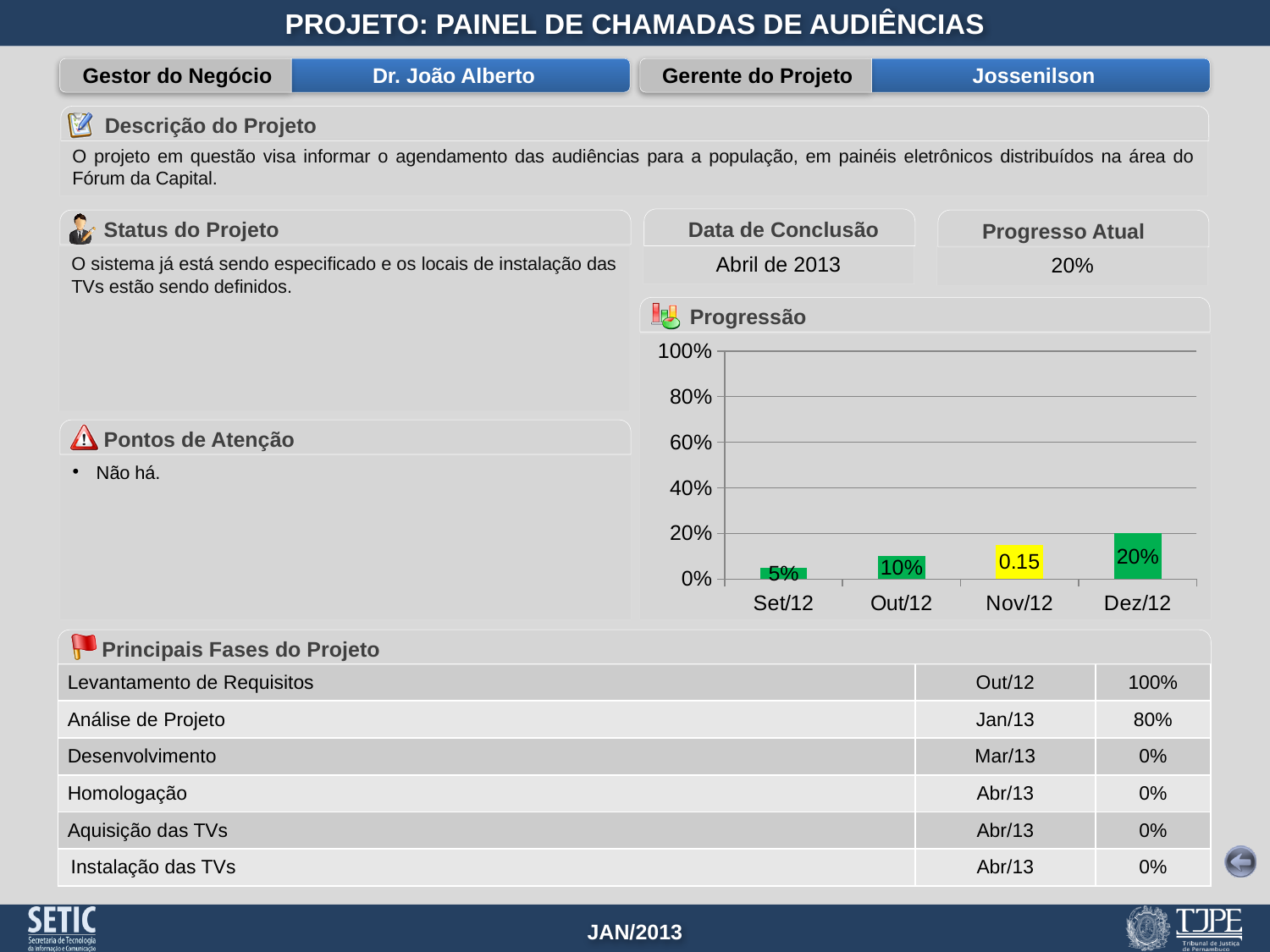
Do the values in the Progressão chart rise or fall from Set/12 to Dez/12? rise Which is larger in the Progressão chart, the value for Out/12 or the value for Dez/12? Dez/12 What is the value shown for Dez/12 in the Progressão chart? 20% What kind of chart is the Progressão chart? bar chart What data label is printed on the Nov/12 bar in the Progressão chart? 0.15 Which month has the lowest value in the Progressão chart? Set/12 How many months are plotted on the x axis of the Progressão chart? 4 Which month has the highest value in the Progressão chart? Dez/12 What is the value shown for Out/12 in the Progressão chart? 10% Is the value for Dez/12 in the Progressão chart greater or less than 40%? less What is the value shown for Set/12 in the Progressão chart? 5% What is the difference between the Dez/12 and Set/12 values in the Progressão chart? 15%